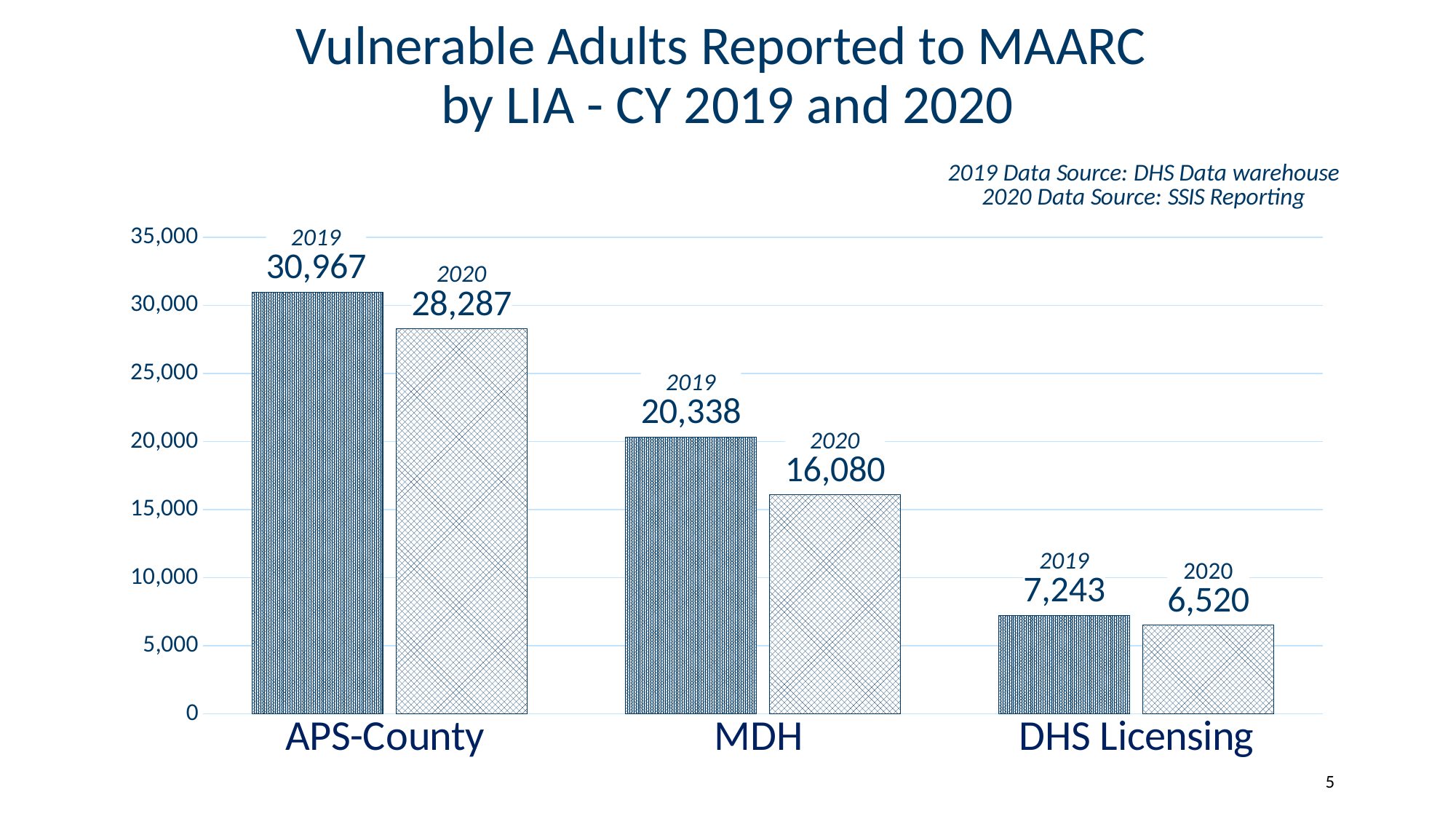
What was the 2020 value for DHS Licensing? 6,520 What was the number of vulnerable adults reported to MAARC by APS-County in 2019? 30,967 Is the 2019 value for DHS Licensing greater or less than 10,000? less What kind of chart is shown on the slide? bar chart What is the difference between the 2019 and 2020 values for APS-County? 2,680 What is the difference between the 2019 and 2020 values for MDH? 4,258 Which is larger: the 2020 value for APS-County or the 2019 value for MDH? 2020 value for APS-County Which LIA had the highest number of vulnerable adults reported in 2019? APS-County Which LIA had the lowest number of vulnerable adults reported in 2020? DHS Licensing How many LIA categories are shown on the x axis? 3 What was the 2020 value for MDH? 16,080 What is the title of the chart? Vulnerable Adults Reported to MAARC by LIA - CY 2019 and 2020